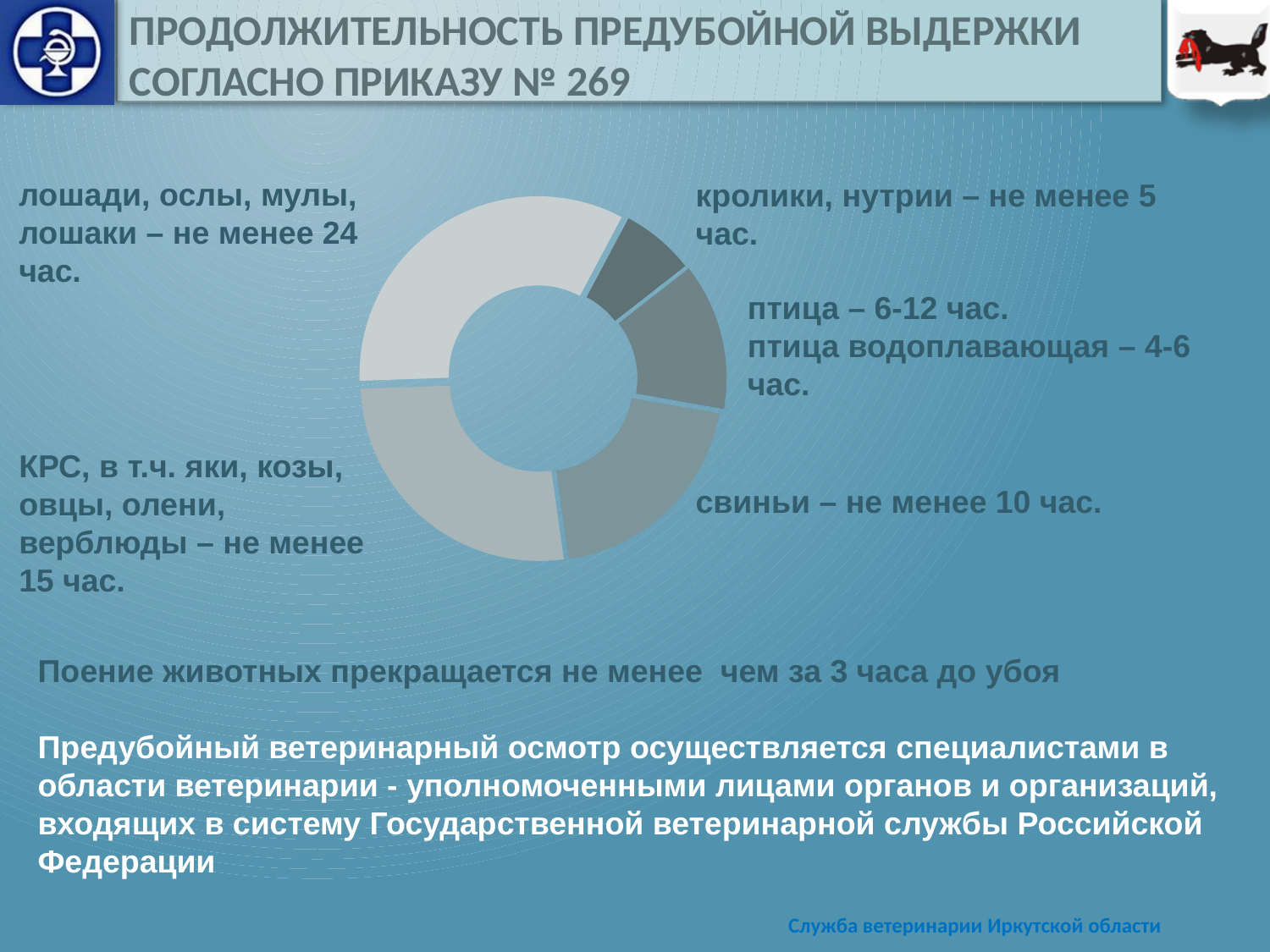
According to the slide, what is the minimum pre-slaughter holding time for свиньи (pigs)? не менее 10 час. Which group has the longer minimum holding time on the slide: лошади (horses) or свиньи (pigs)? лошади According to the slide, what is the minimum pre-slaughter holding time for лошади, ослы, мулы, лошаки? не менее 24 час. What kind of chart is shown on the slide? Donut (pie) chart What is the title of the slide containing the chart? ПРОДОЛЖИТЕЛЬНОСТЬ ПРЕДУБОЙНОЙ ВЫДЕРЖКИ СОГЛАСНО ПРИКАЗУ № 269 According to the slide, what is the pre-slaughter holding time for птица водоплавающая? 4-6 час. How many slices does the donut chart have? 5 According to the slide, what is the minimum pre-slaughter holding time for кролики, нутрии? не менее 5 час. According to the slide, what is the minimum pre-slaughter holding time for КРС, в т.ч. яки, козы, овцы, олени, верблюды? не менее 15 час. Does the donut chart on the slide have a legend? No